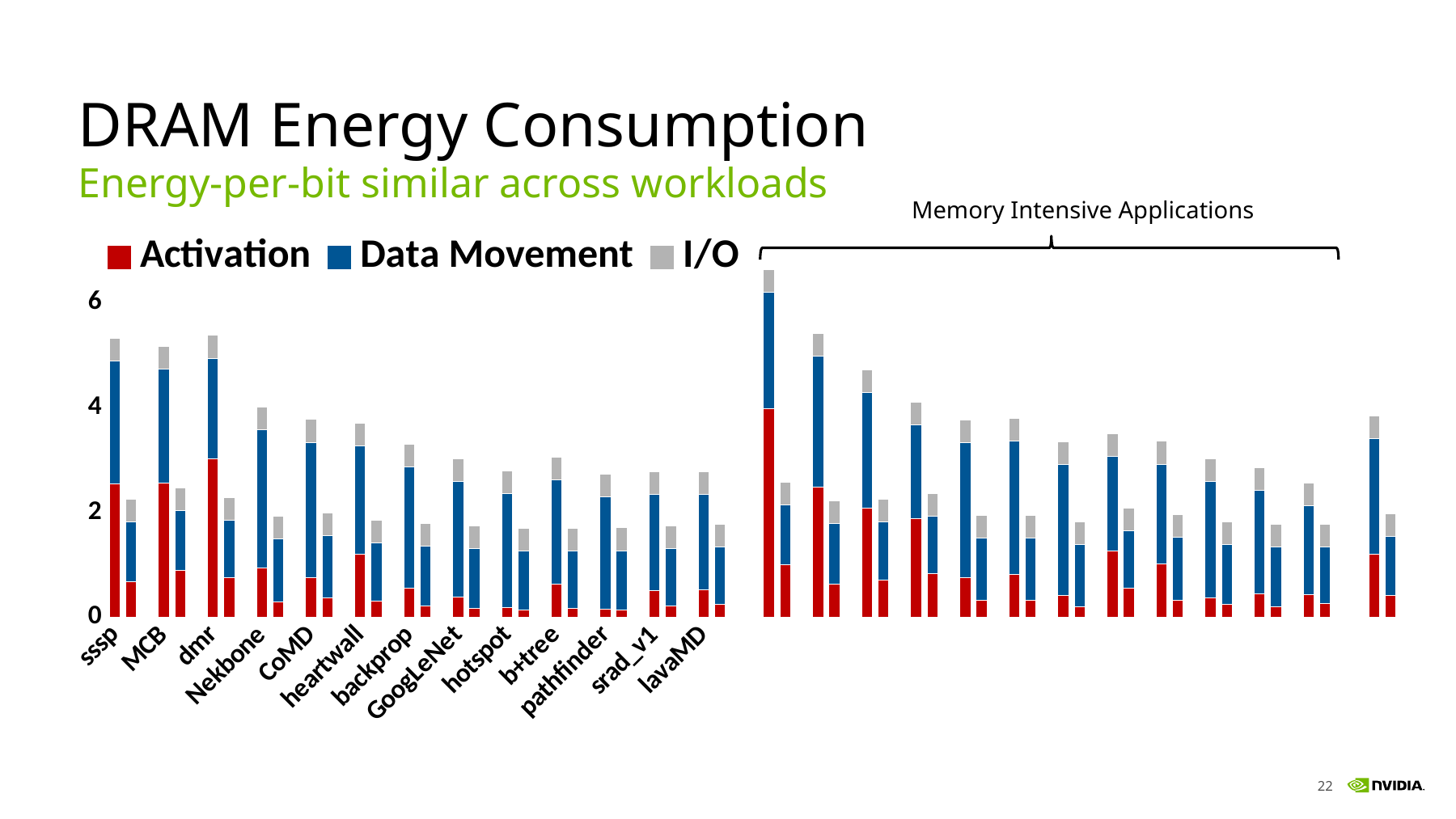
Which series is shown in red? Activation What kind of chart is shown on the slide? stacked bar chart Is the total of the left bar of the pair for dmr greater or less than 4? greater Is the Activation segment of the left bar for dmr greater or less than 2? greater Which has the taller left bar, sssp or Nekbone? sssp How many labeled categories are on the x axis? 13 How many series does the legend list? 3 Is the total of the left bar of the pair for sssp greater or less than 4? greater What are the three series named in the legend? Activation, Data Movement, I/O What is the highest value shown on the y axis? 6